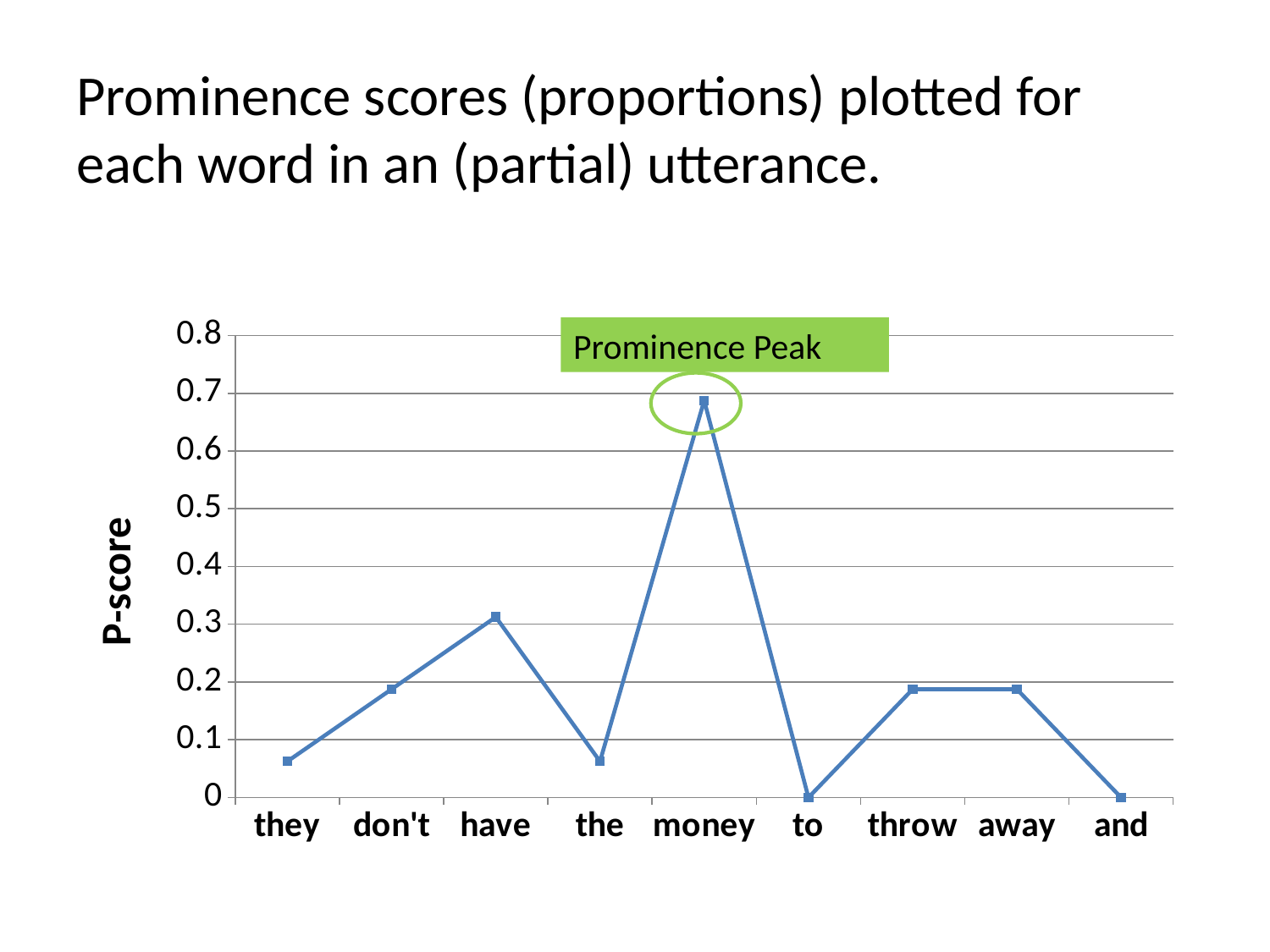
How many words are plotted along the x axis? 9 Which has a higher P-score, "have" or "don't"? have What kind of chart is shown on the slide? line chart Which word has the highest P-score? money Is the P-score for "have" greater or less than 0.2? greater Do the P-scores rise or fall from "they" to "have"? rise What is the P-score for "to"? 0 What is the label on the y axis? P-score Is the P-score for "money" greater or less than 0.6? greater What is the P-score for "and"? 0 What does the green annotation box above the highest point say? Prominence Peak Is the P-score for "they" greater or less than 0.1? less